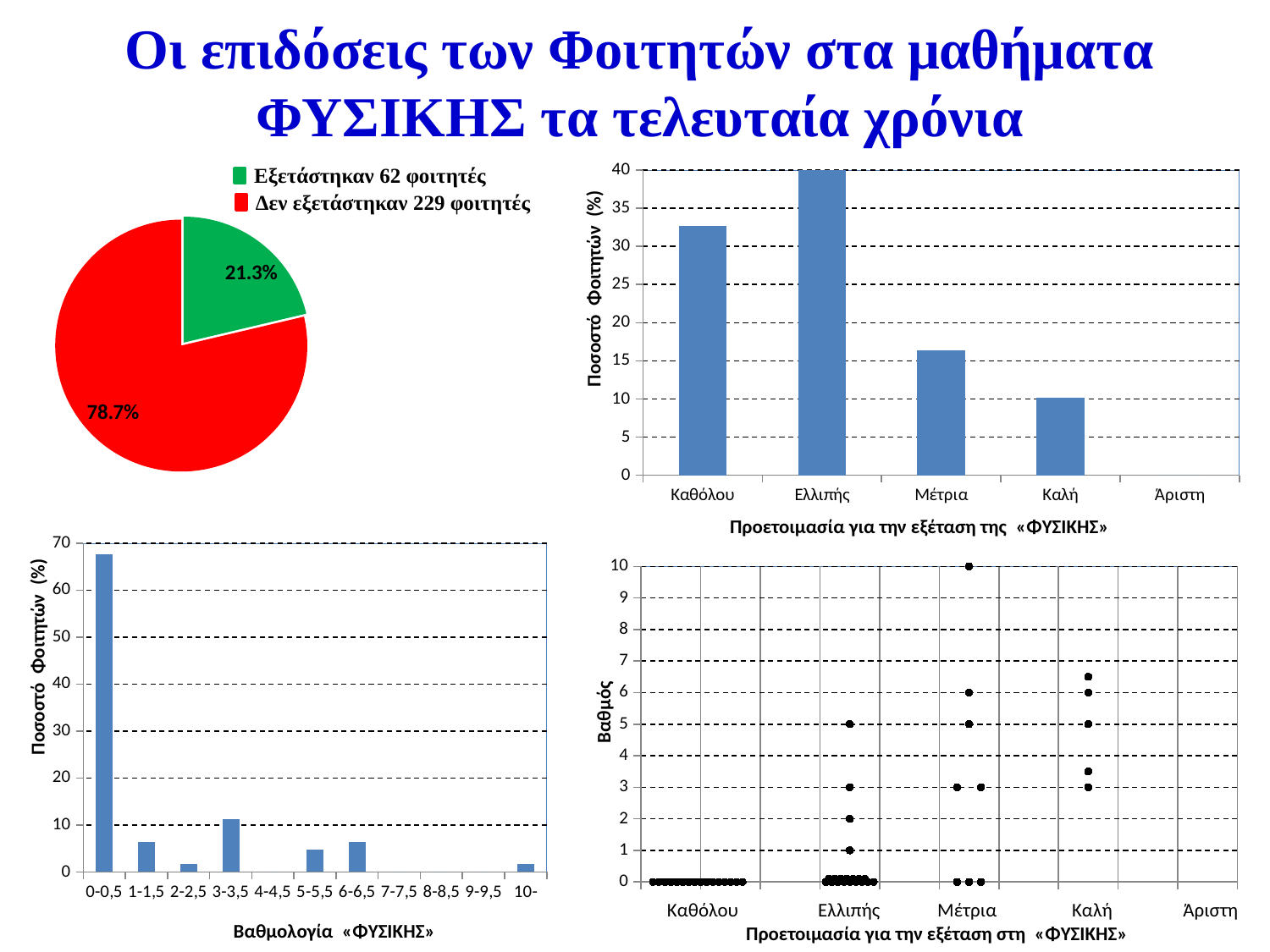
In the top-right chart (Προετοιμασία για την εξέταση της «ΦΥΣΙΚΗΣ»), is the value for Καθόλου greater or less than 30? greater In the pie chart at the top left, which slice is larger, Εξετάστηκαν or Δεν εξετάστηκαν? Δεν εξετάστηκαν In the top-right chart (Προετοιμασία για την εξέταση της «ΦΥΣΙΚΗΣ»), which category has the highest percentage of students? Ελλιπής In the bottom-left chart (Βαθμολογία «ΦΥΣΙΚΗΣ»), is the value for 0-0,5 greater or less than 60? greater In the pie chart at the top left, how many students does the legend say were examined (Εξετάστηκαν)? 62 In the top-right chart (Προετοιμασία για την εξέταση της «ΦΥΣΙΚΗΣ»), is the value for Μέτρια greater or less than 20? less What kind of chart is the bottom-right chart (Προετοιμασία για την εξέταση στη «ΦΥΣΙΚΗΣ» vs Βαθμός)? scatter chart In the bottom-left chart (Βαθμολογία «ΦΥΣΙΚΗΣ»), which grade range has the highest percentage of students? 0-0,5 In the top-right chart (Προετοιμασία για την εξέταση της «ΦΥΣΙΚΗΣ»), how many categories are shown on the x axis? 5 In the top-right chart (Προετοιμασία για την εξέταση της «ΦΥΣΙΚΗΣ»), which is larger, the value for Καθόλου or the value for Καλή? Καθόλου In the pie chart at the top left, what share of the pie is the green slice (Εξετάστηκαν)? 21.3% In the pie chart at the top left, what share of the pie is the red slice (Δεν εξετάστηκαν)? 78.7%